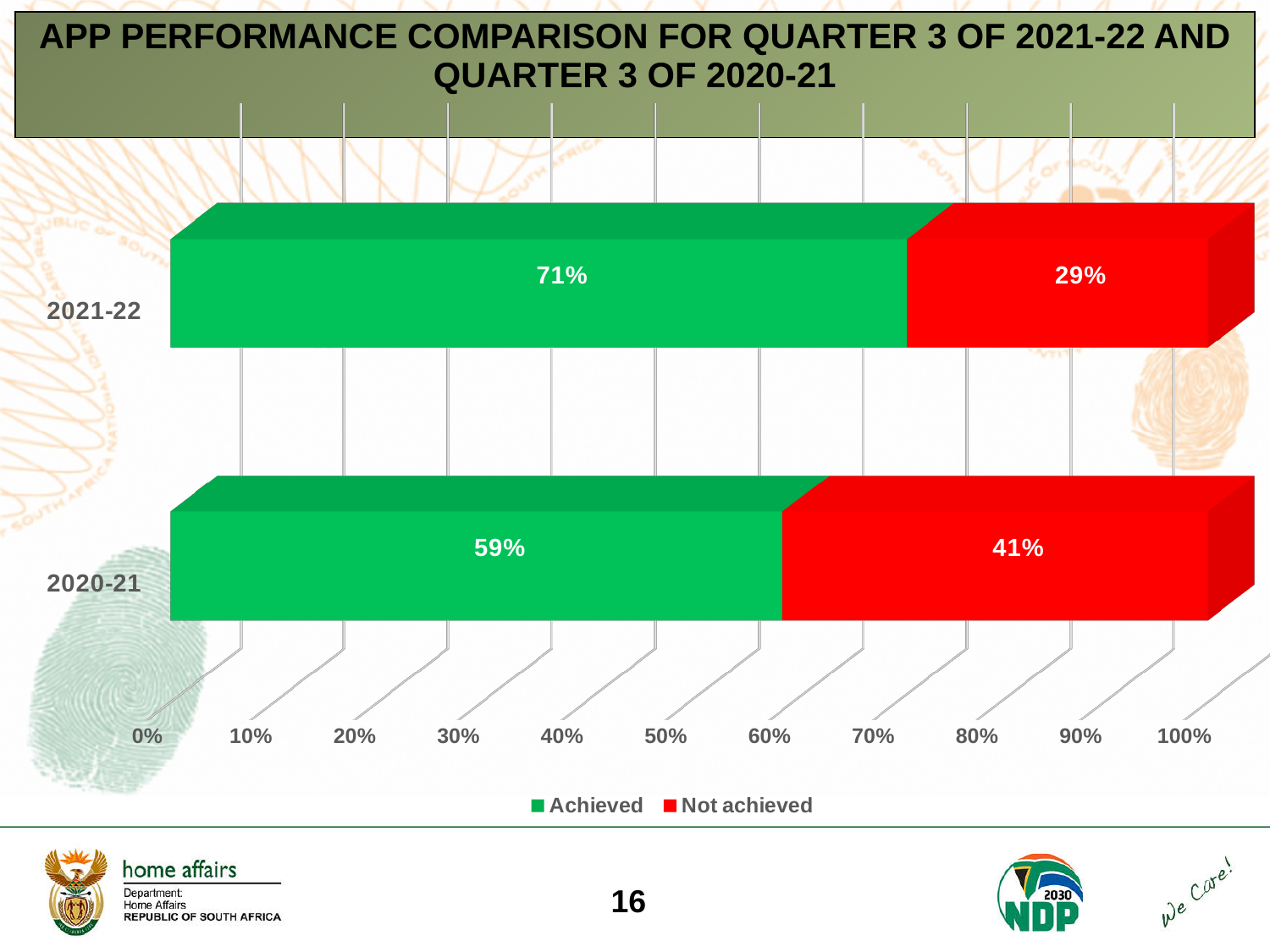
What is the 'Achieved' value for 2020-21? 59% What is the total of the stacked bar for 2021-22? 100% What type of chart is shown on the slide? Stacked bar chart How many series does the legend list? 2 By how many percentage points did the 'Achieved' share increase from 2020-21 to 2021-22? 12 What is the 'Not achieved' value for 2021-22? 29% Which year has the lower 'Not achieved' percentage? 2021-22 Is the 'Achieved' value for 2020-21 larger or smaller than the 'Not achieved' value for 2020-21? larger How many years (categories) are shown in the chart? 2 What percentage of targets was achieved in 2021-22? 71% Which year has the higher 'Achieved' percentage? 2021-22 What percentage of targets was not achieved in 2020-21? 41%